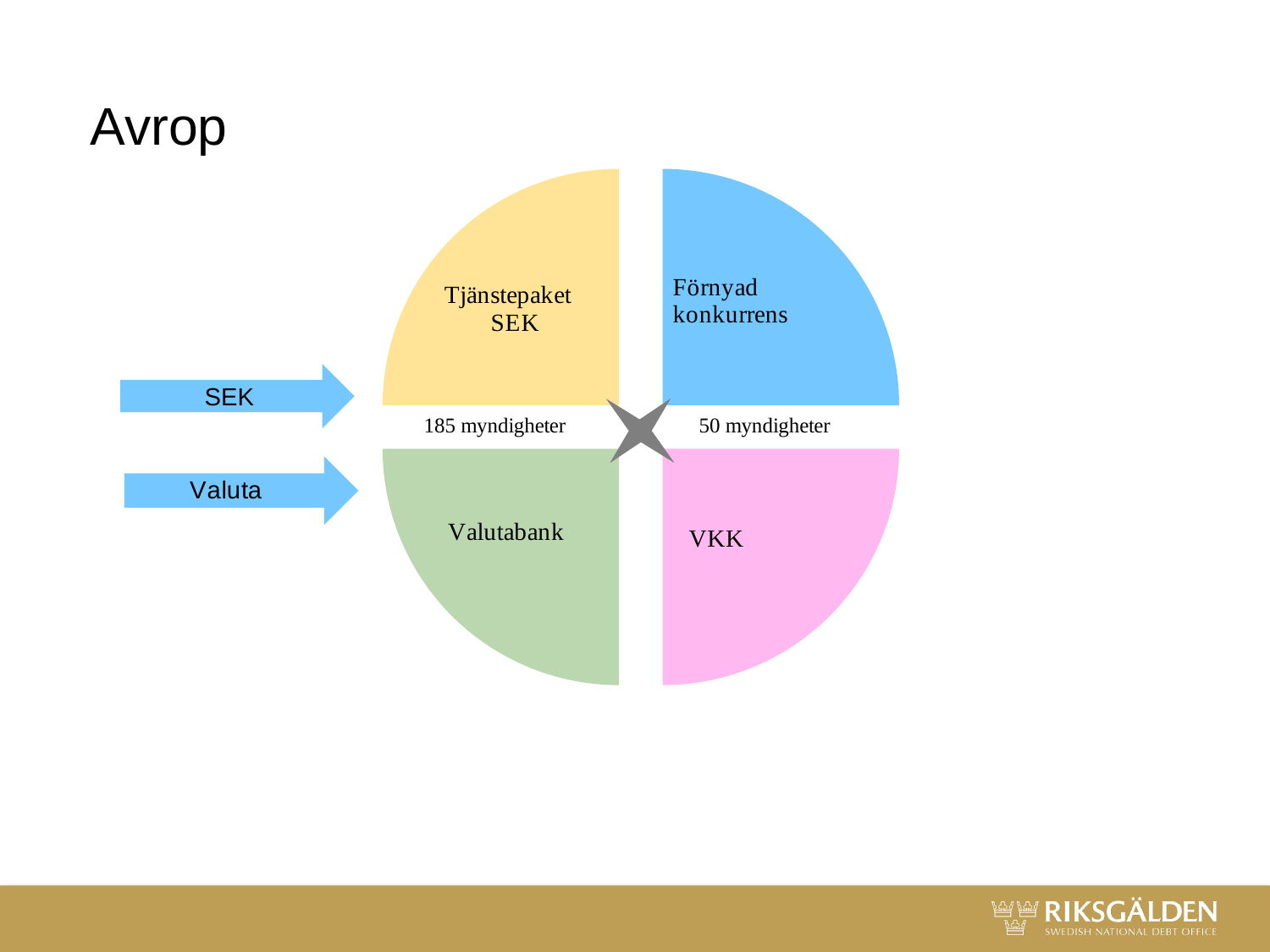
Which side of the circle diagram shows more myndigheter, the left (185) or the right (50)? left What is the label of the green segment in the bottom-left of the circle diagram? Valutabank How many myndigheter are shown on the left side of the circle diagram? 185 myndigheter How many segments does the circle diagram on the slide have? 4 What is the label of the yellow segment in the top-left of the circle diagram? Tjänstepaket SEK What is the difference between the 185 myndigheter on the left and the 50 myndigheter on the right of the circle diagram? 135 myndigheter What is the title of the slide containing the circle diagram? Avrop How many myndigheter are shown on the right side of the circle diagram? 50 myndigheter What is the label of the blue segment in the top-right of the circle diagram? Förnyad konkurrens What are the two labels on the arrows pointing into the circle diagram from the left? SEK and Valuta What is the label of the pink segment in the bottom-right of the circle diagram? VKK